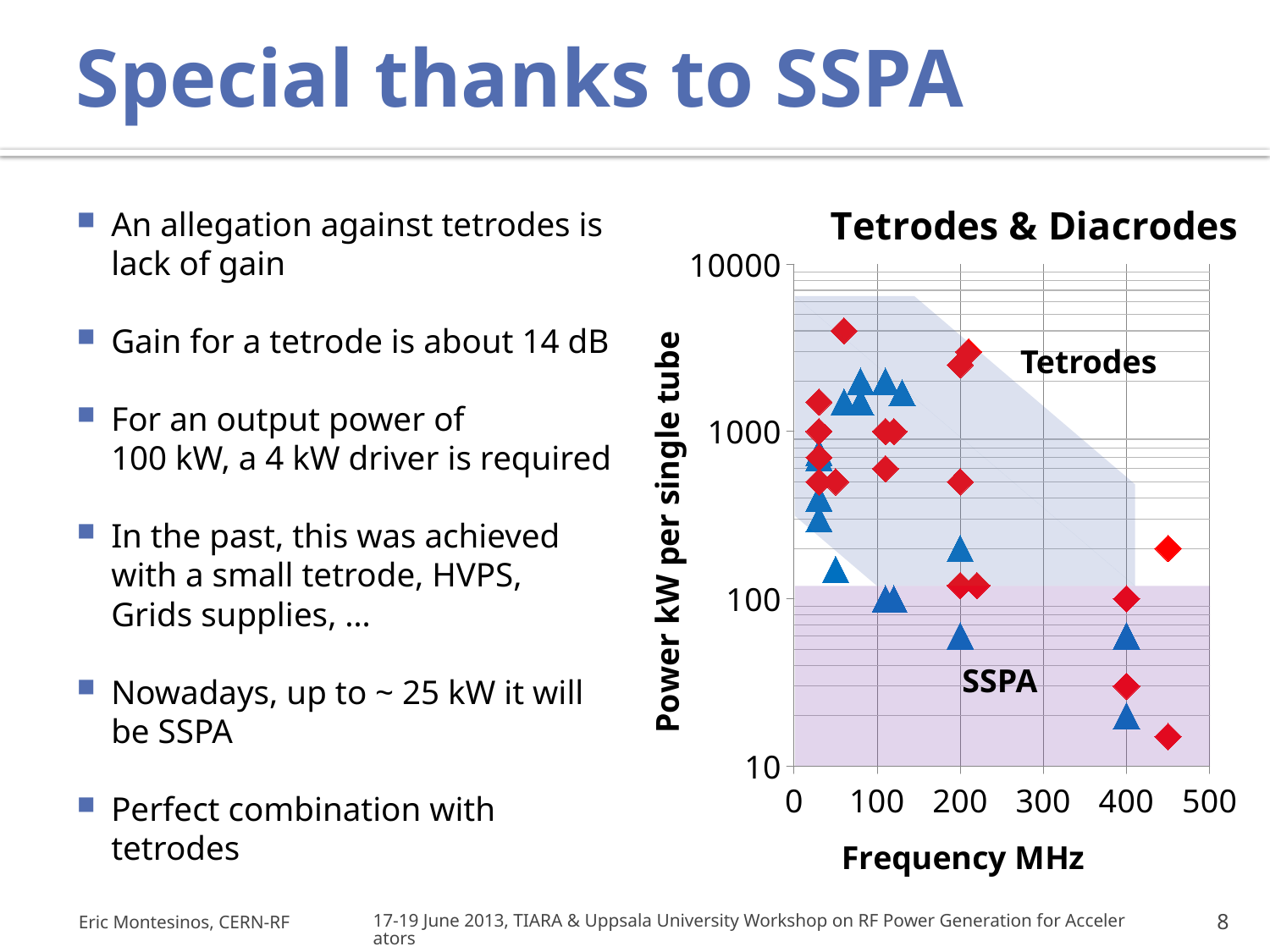
Is the power of the lowest blue triangle greater or less than 100? less Is the power of the lowest plotted point greater or less than 100? less Is the power of the highest blue triangle greater or less than 1000? greater How many tick labels are shown on the x axis (Frequency MHz)? 6 Which label appears in the lower shaded region of the chart? SSPA How many tick labels are shown on the y axis (Power kW per single tube)? 4 Which marker type reaches the highest power on the chart, the red diamonds or the blue triangles? Red diamonds What is the title of the chart? Tetrodes & Diacrodes What kind of chart is shown on the slide? Scatter chart